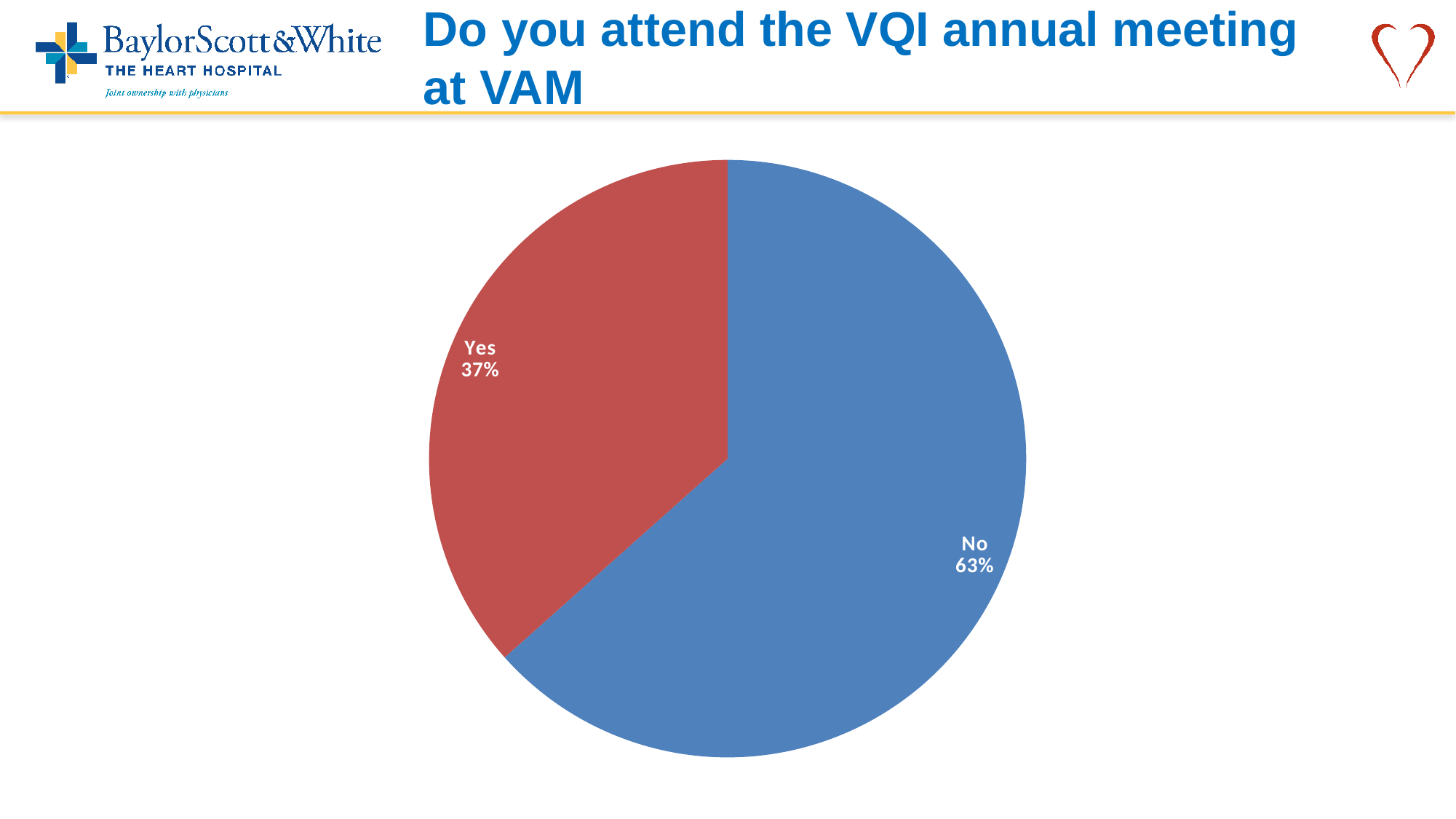
Which response has the largest share of the pie? No What is the difference in percentage points between the "No" and "Yes" slices? 26 What percentage of respondents answered "No"? 63% What kind of chart is shown on the slide? Pie chart Which is larger, the "Yes" slice or the "No" slice? No What colour is the "Yes" slice? Red How many slices does the pie chart have? 2 What share of the pie does the "No" slice represent? 63% What percentage of respondents answered "Yes"? 37% Which response has the smallest share of the pie? Yes What is the title of the slide containing the chart? Do you attend the VQI annual meeting at VAM